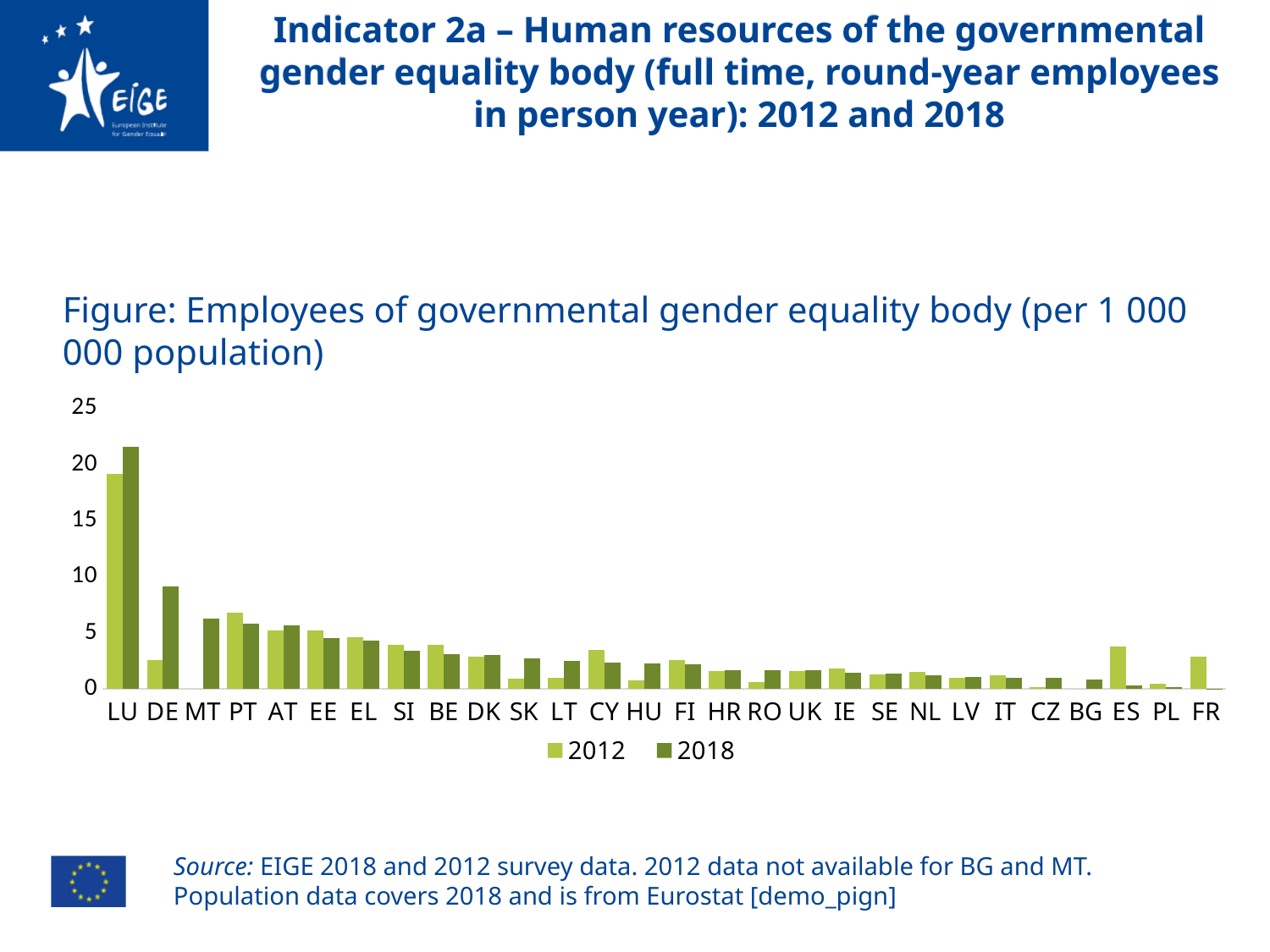
What kind of chart is shown on the slide? bar chart How many series does the legend list? 2 Is the 2012 value for PT greater or less than 5? greater Which country has the highest value for 2012? LU Which country has the highest value for 2018? LU Is the 2012 value for ES greater or less than 5? less For FR, which year has the larger value, 2012 or 2018? 2012 How many countries are shown on the x axis? 28 For DE, which year has the larger value, 2012 or 2018? 2018 Is the 2018 value for DE greater or less than 10? less Do the 2018 values generally rise or fall from left to right along the x axis? fall